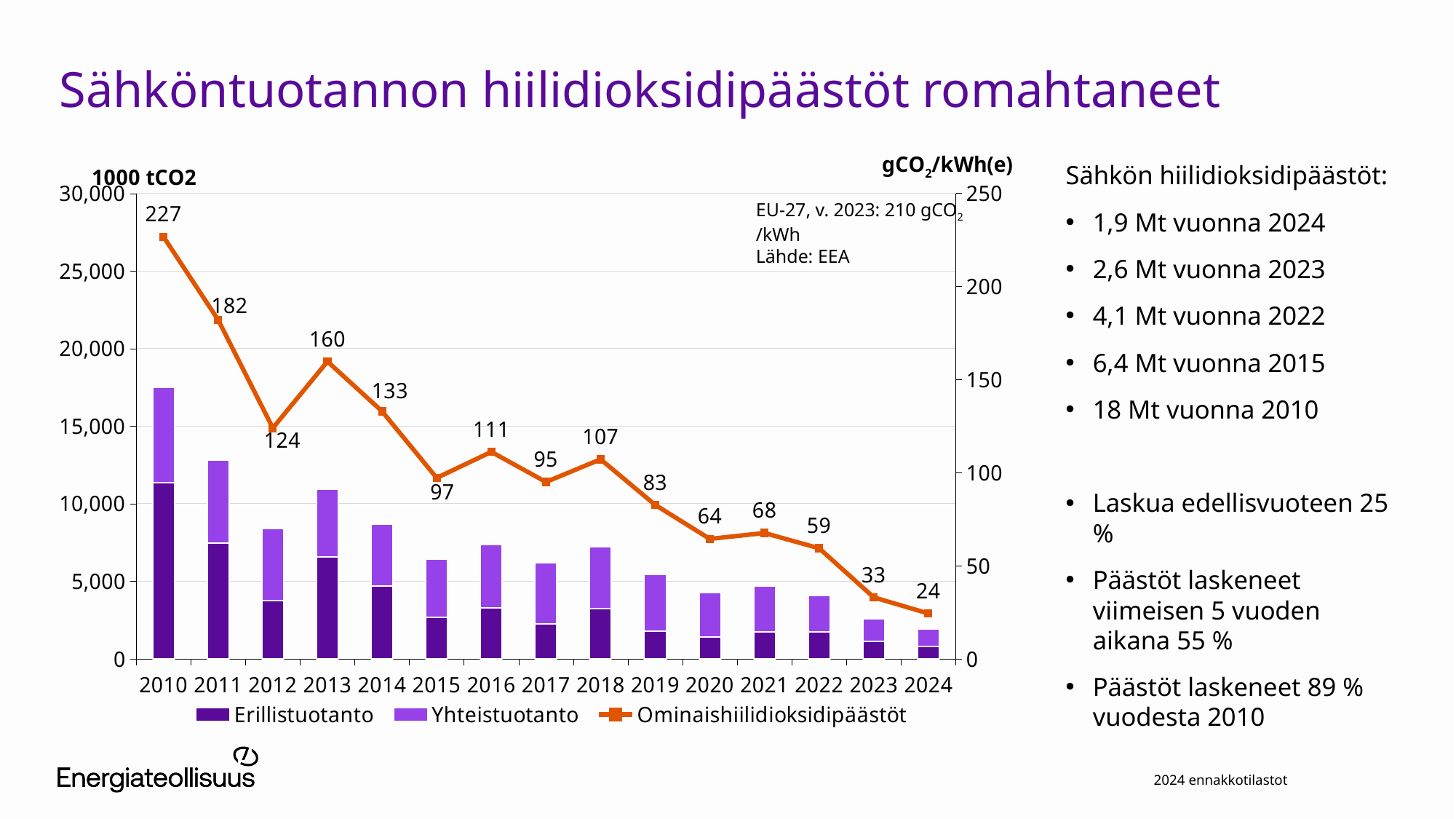
In which year is Ominaishiilidioksidipäästöt highest? 2010 What is the value of Ominaishiilidioksidipäästöt for 2010? 227 What is the difference between the Ominaishiilidioksidipäästöt values for 2010 and 2024? 203 Which year has a higher Ominaishiilidioksidipäästöt value, 2012 or 2013? 2013 What is the overall trend of Ominaishiilidioksidipäästöt from 2010 to 2024? falling How many series does the legend list? 3 How many years are shown on the x axis? 15 What is the value of Ominaishiilidioksidipäästöt for 2016? 111 In which year is Ominaishiilidioksidipäästöt lowest? 2024 Is the total stacked bar for 2010 greater or less than 15,000? greater Is the total stacked bar for 2024 greater or less than 5,000? less What is the value of Ominaishiilidioksidipäästöt for 2024? 24